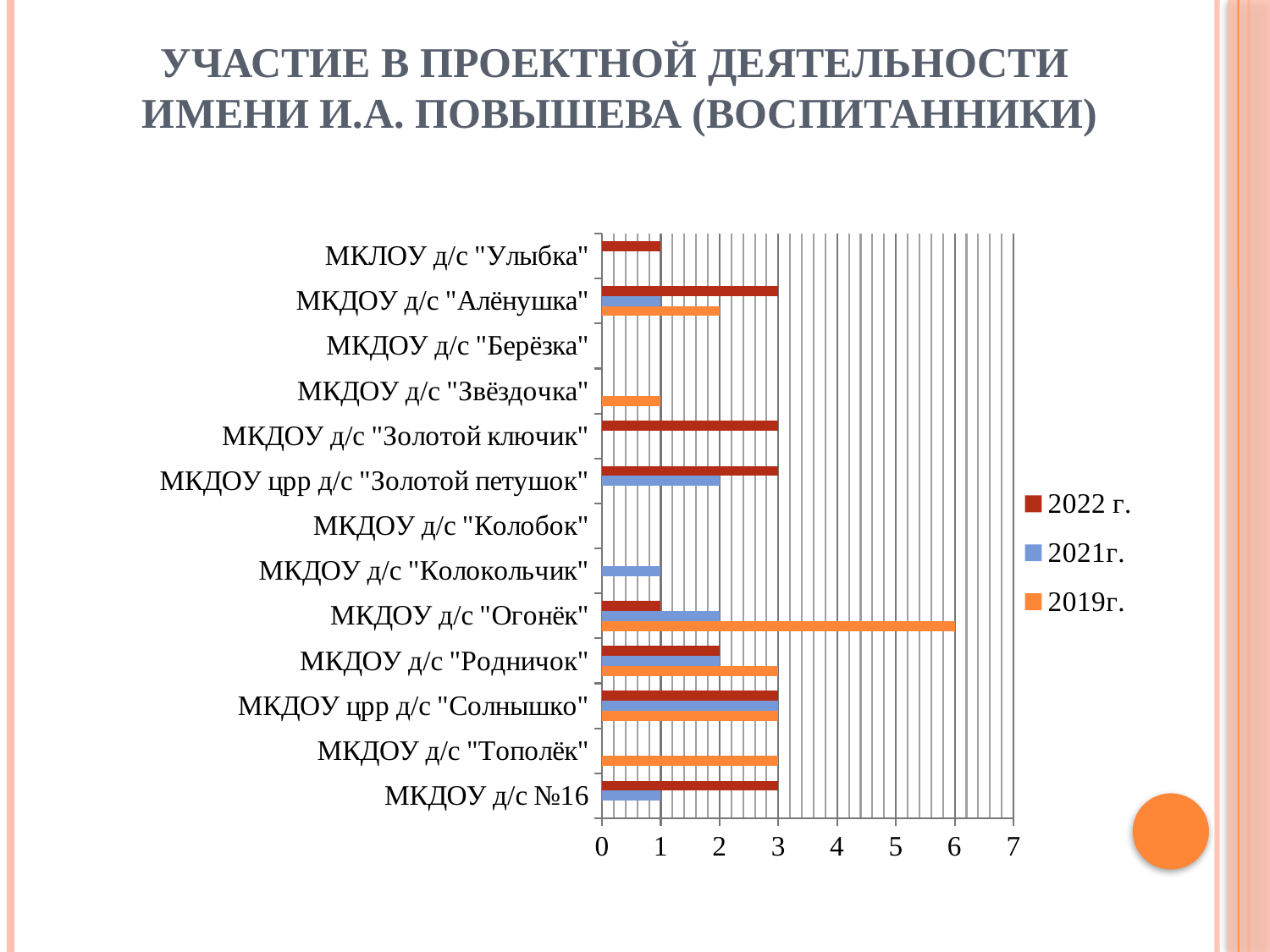
How many categories (kindergartens) are listed on the vertical axis? 13 How many series does the legend list? 3 Which legend entry is shown in orange? 2019г. What is the value for МКДОУ црр д/с "Солнышко" in the 2022 г. series? 3 Which category has the highest value in the 2019г. series? МКДОУ д/с "Огонёк" Which is larger for МКДОУ д/с "Родничок": the 2019г. value or the 2022 г. value? 2019г. What is the value for МКДОУ д/с "Огонёк" in the 2019г. series? 6 What is the difference between the 2019г. value and the 2021г. value for МКДОУ д/с "Огонёк"? 4 Is the value for МКДОУ д/с "Огонёк" in the 2019г. series greater or less than 5? greater What kind of chart is shown on the slide? bar chart What is the value for МКДОУ д/с "Алёнушка" in the 2019г. series? 2 What is the value for МКДОУ црр д/с "Золотой петушок" in the 2021г. series? 2